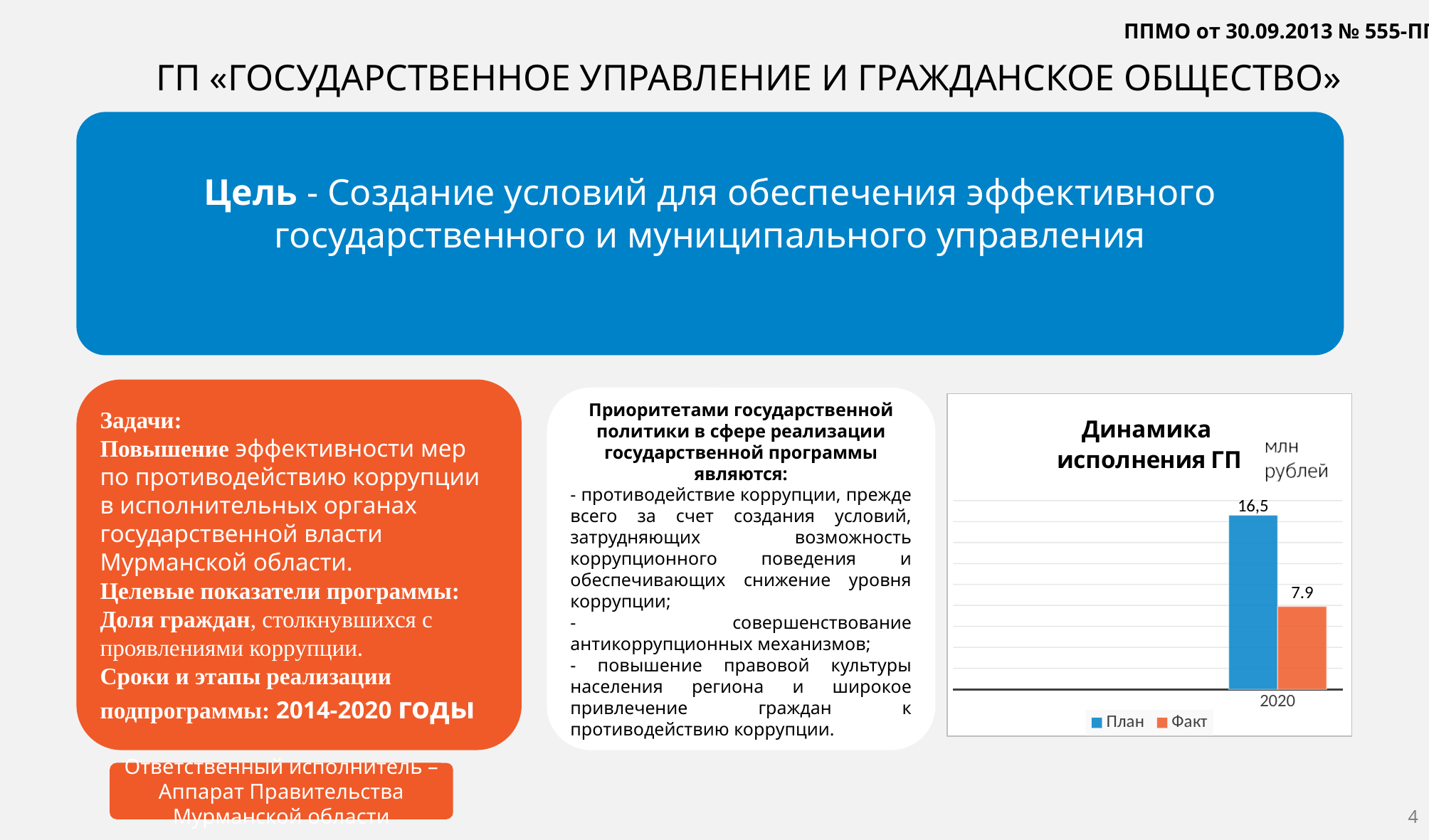
What is the value of the План series for 2020 in the chart 'Динамика исполнения ГП'? 16,5 In the chart 'Динамика исполнения ГП', which series has the lowest value? Факт How many categories are shown on the x axis of the chart 'Динамика исполнения ГП'? 1 In the chart 'Динамика исполнения ГП', which series has the higher value for 2020, План or Факт? План What unit is indicated next to the title of the chart 'Динамика исполнения ГП'? млн рублей How many series does the legend of the chart 'Динамика исполнения ГП' list? 2 What is the title of the chart on the right side of the slide? Динамика исполнения ГП What is the difference between the План and Факт values for 2020 in the chart 'Динамика исполнения ГП'? 8,6 In the chart 'Динамика исполнения ГП', which series has the highest value? План What is the value of the Факт series for 2020 in the chart 'Динамика исполнения ГП'? 7.9 What kind of chart is 'Динамика исполнения ГП'? bar chart Which year is shown on the x axis of the chart 'Динамика исполнения ГП'? 2020